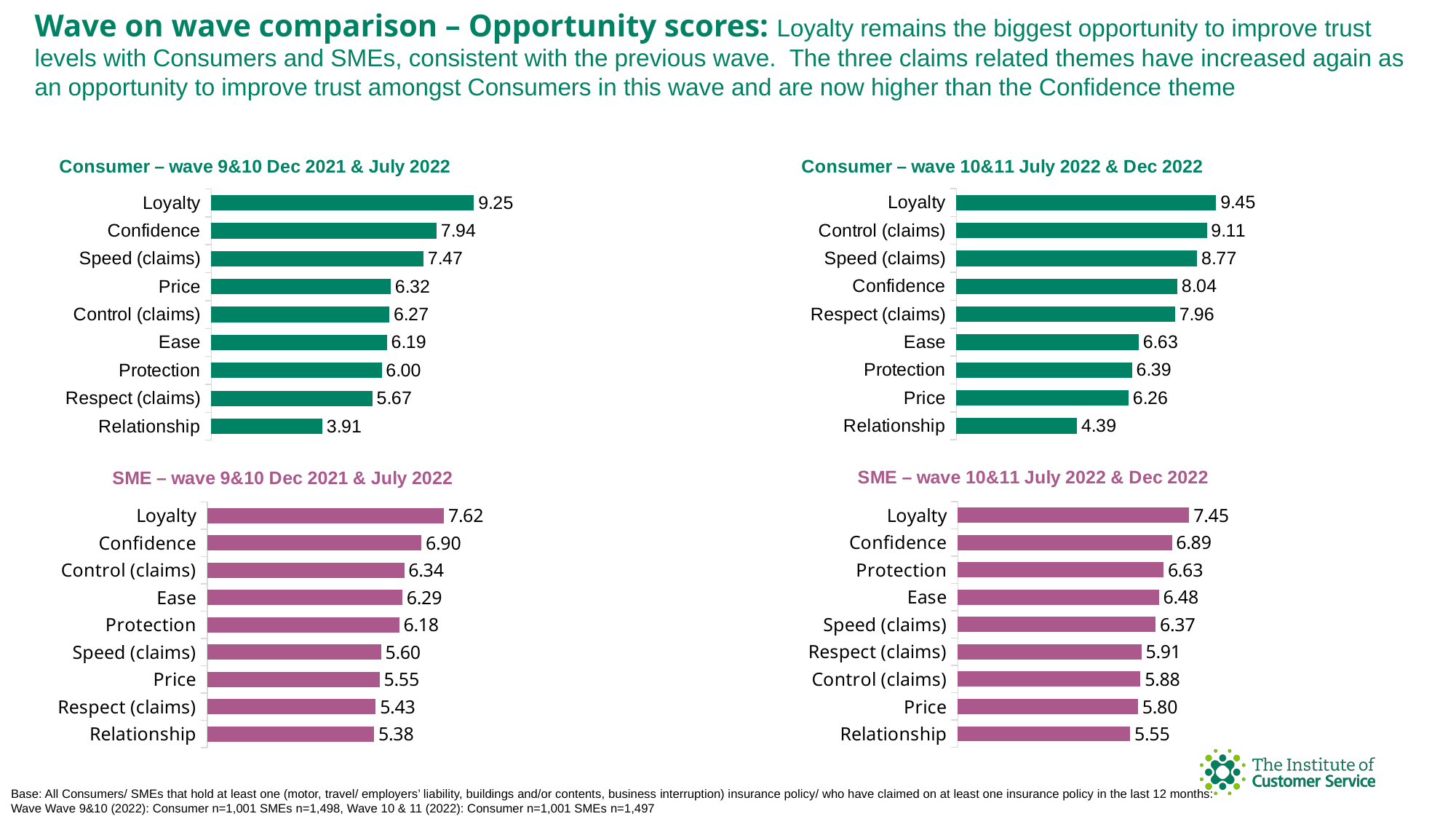
In the 'SME – wave 9&10 Dec 2021 & July 2022' chart, which is larger, Price or Protection? Protection In the 'Consumer – wave 10&11 July 2022 & Dec 2022' chart, what is the value for Control (claims)? 9.11 How many charts are shown on the slide? 4 What type of chart is the 'SME – wave 10&11 July 2022 & Dec 2022' chart? Bar chart In the 'Consumer – wave 10&11 July 2022 & Dec 2022' chart, which is larger, Confidence or Speed (claims)? Speed (claims) In the 'SME – wave 9&10 Dec 2021 & July 2022' chart, what is the value for Speed (claims)? 5.60 In the 'Consumer – wave 9&10 Dec 2021 & July 2022' chart, what is the difference between Loyalty and Relationship? 5.34 In the 'SME – wave 10&11 July 2022 & Dec 2022' chart, which category has the lowest value? Relationship In the 'Consumer – wave 10&11 July 2022 & Dec 2022' chart, which category has the highest value? Loyalty In the 'SME – wave 10&11 July 2022 & Dec 2022' chart, what is the difference between Loyalty and Confidence? 0.56 How many categories are shown in the 'Consumer – wave 9&10 Dec 2021 & July 2022' chart? 9 In the 'Consumer – wave 9&10 Dec 2021 & July 2022' chart, what is the value for Loyalty? 9.25